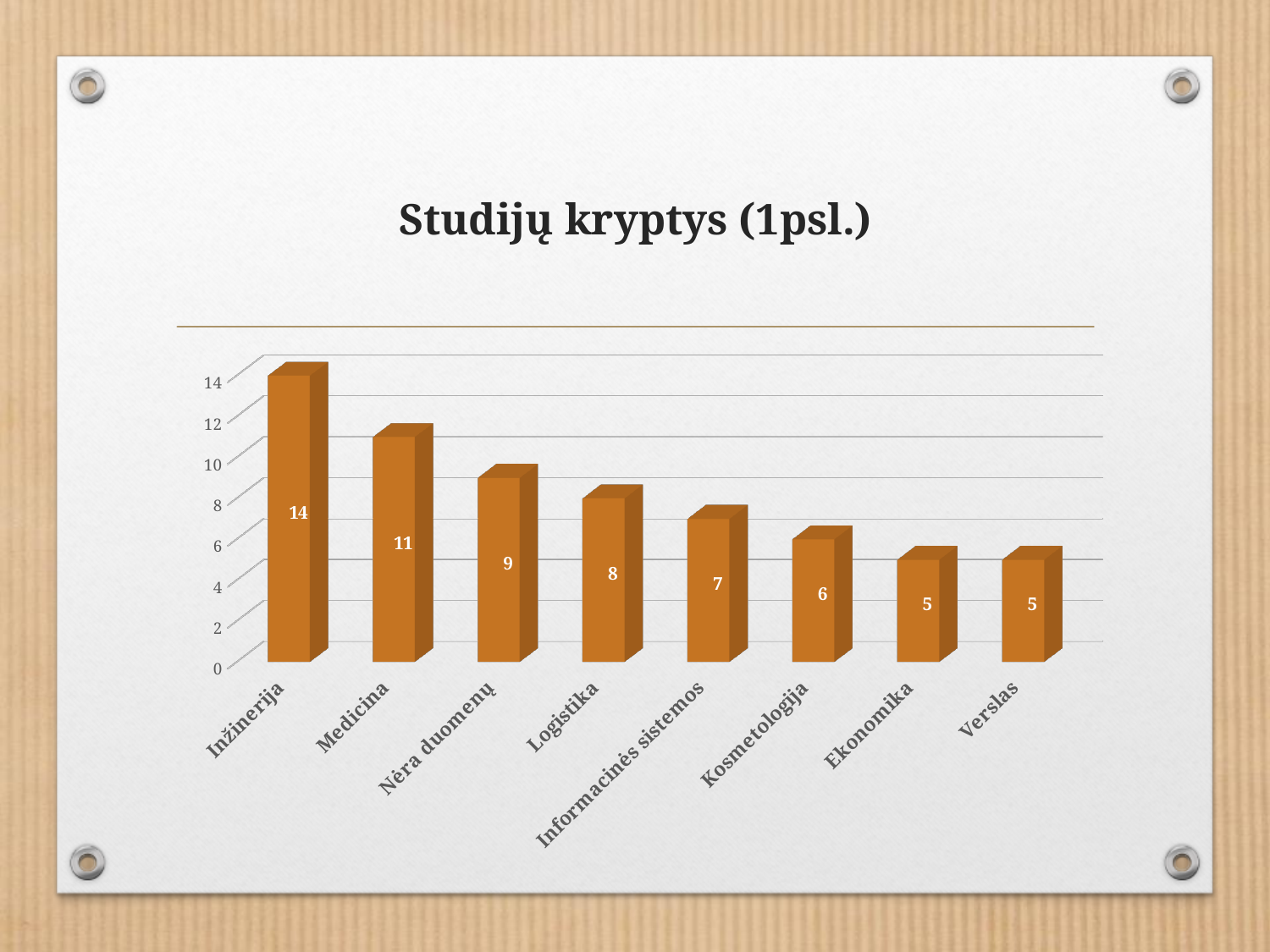
What is the difference between the values for Inžinerija and Medicina? 3 Do the values rise or fall from left to right along the x axis? fall What is the title of the slide? Studijų kryptys (1psl.) Which is larger, the value for Logistika or the value for Ekonomika? Logistika What is the value for Medicina? 11 What is the difference between the values for Nėra duomenų and Logistika? 1 What is the value for Inžinerija? 14 Which category has the highest value? Inžinerija How many categories are shown on the x axis? 8 What kind of chart is shown on the slide? bar chart What is the value for Kosmetologija? 6 What is the value for Informacinės sistemos? 7